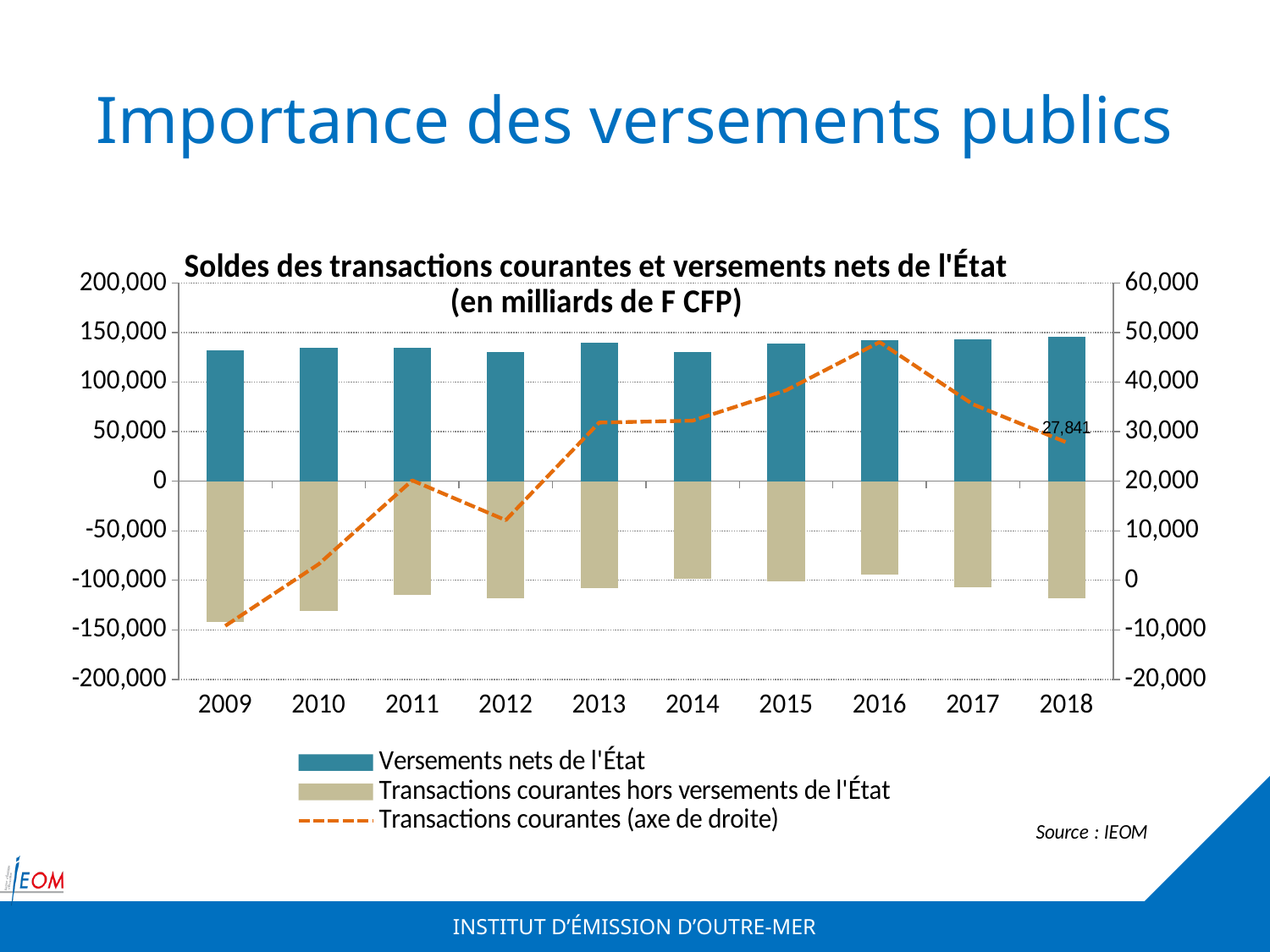
Is the value of Transactions courantes hors versements de l'État in 2009 greater or less than -100,000? less In which year is the Transactions courantes (axe de droite) line at its highest? 2016 Does the Transactions courantes (axe de droite) line rise or fall between 2012 and 2016? rise What kind of chart is shown on the slide? combined bar and line chart Is the value of Transactions courantes (axe de droite) in 2011 greater or less than 10,000 on the right axis? greater How many series does the chart legend list? 3 In which year is the Transactions courantes (axe de droite) line at its lowest? 2009 How many years are shown on the x axis of the chart? 10 Which year has the larger value for Versements nets de l'État, 2012 or 2018? 2018 Is the value of Versements nets de l'État in 2009 greater or less than 100,000? greater What is the value of Transactions courantes (axe de droite) in 2018? 27,841 Which series is plotted on the right-hand axis of the chart? Transactions courantes (axe de droite)